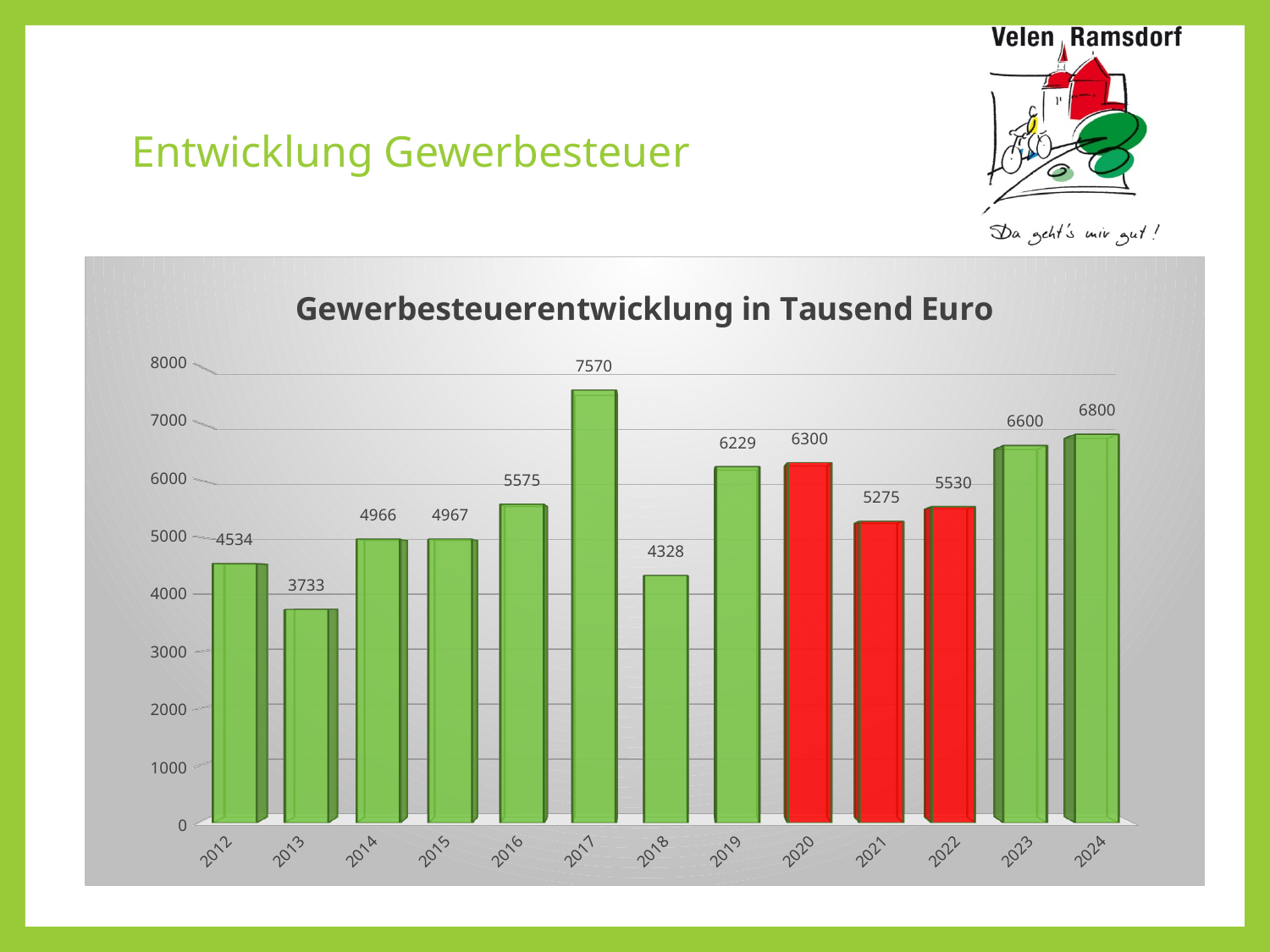
What is the value for 2017? 7570 What is the difference between the values for 2017 and 2018? 3242 How many years are shown on the x axis? 13 What is the title of the chart? Gewerbesteuerentwicklung in Tausend Euro What is the value for 2013? 3733 What is the value for 2024? 6800 Is the value for 2019 greater or less than 6000? greater What kind of chart is this? Bar chart Which year has the lowest value? 2013 Which is larger, the value for 2020 or the value for 2021? 2020 Do the values rise or fall from 2022 to 2024? Rise Which year has the highest value? 2017